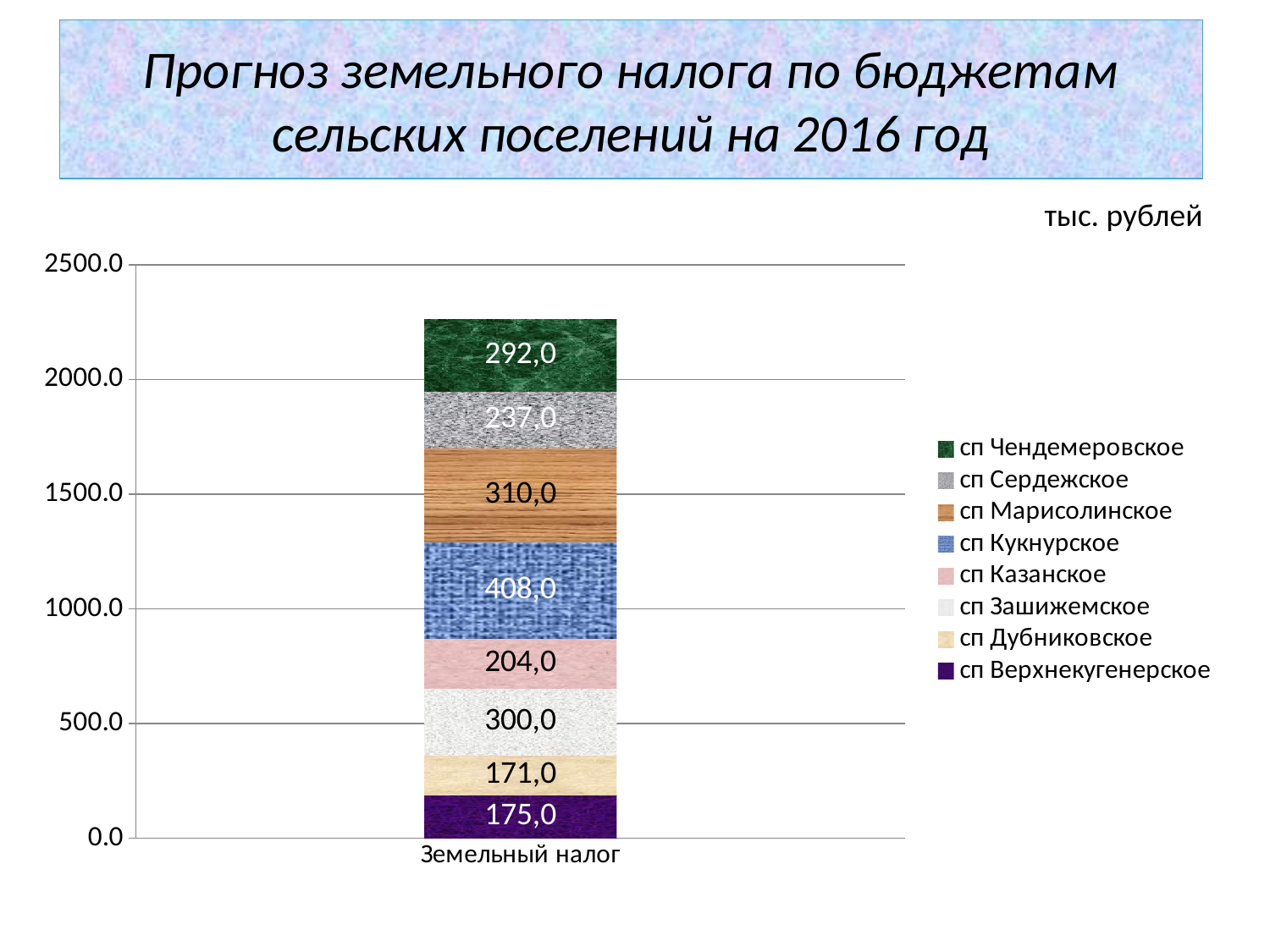
What is the value for сп Кукнурское? 408,0 What is the difference between the values for сп Марисолинское and сп Сердежское? 73,0 Which settlement has the lowest land tax forecast? сп Дубниковское Is the total height of the stacked bar greater or less than 2500? less Which is larger, the value for сп Зашижемское or the value for сп Казанское? сп Зашижемское What is the value for сп Дубниковское? 171,0 How many series does the legend list? 8 What is the value for сп Чендемеровское? 292,0 What is the total of the stacked bar for Земельный налог? 2097,0 Which settlement has the highest land tax forecast? сп Кукнурское What unit is indicated above the chart? тыс. рублей What type of chart is shown on the slide? stacked bar chart